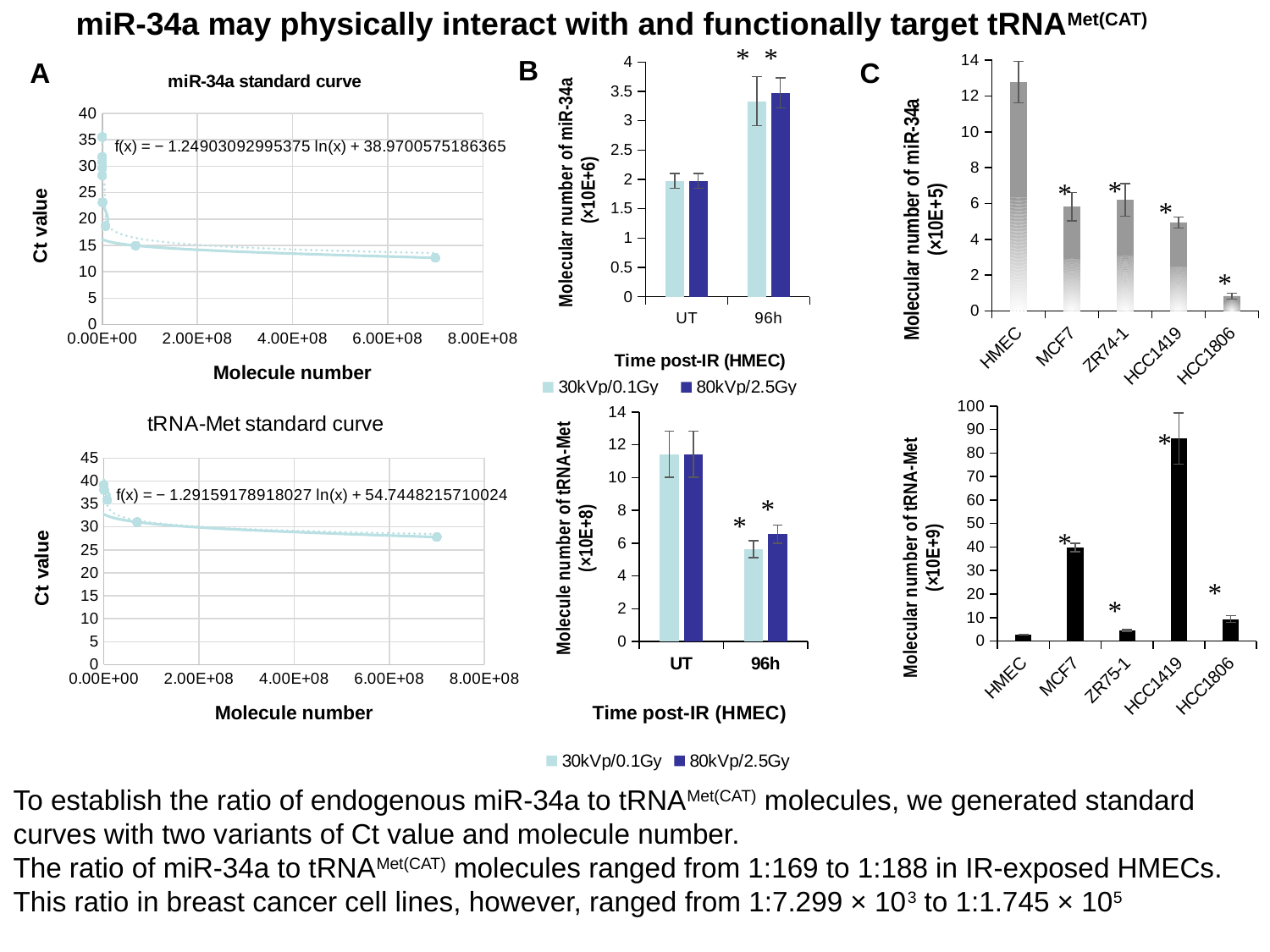
In panel A, does the Ct value rise or fall as the molecule number increases along the x axis of the 'tRNA-Met standard curve' chart? fall In panel C, which cell line has the lowest value in the 'Molecular number of miR-34a (×10E+5)' chart? HCC1806 In panel B, in the 'Molecule number of tRNA-Met (×10E+8)' chart, which is larger for 30kVp/0.1Gy: UT or 96h? UT In panel B, in the 'Molecular number of miR-34a (×10E+6)' chart, is the 80kVp/2.5Gy value at 96h greater or less than 3? greater In panel C, which cell line has the highest value in the 'Molecular number of miR-34a (×10E+5)' chart? HMEC In panel C, in the 'Molecular number of tRNA-Met (×10E+9)' chart, is the value for MCF7 greater or less than 30? greater In panel C, how many cell lines are shown on the x axis of the 'Molecular number of miR-34a (×10E+5)' chart? 5 In panel B, in the 'Molecule number of tRNA-Met (×10E+8)' chart, is the 30kVp/0.1Gy value at 96h greater or less than 8? less In panel A, what is the fitted equation shown on the 'miR-34a standard curve' chart? f(x) = − 1.24903092995375 ln(x) + 38.9700575186365 In panel B, how many series does the legend list for the 'Molecular number of miR-34a (×10E+6)' chart? 2 In panel A, what kind of chart is the 'miR-34a standard curve'? scatter chart In panel C, which cell line has the highest value in the 'Molecular number of tRNA-Met (×10E+9)' chart? HCC1419